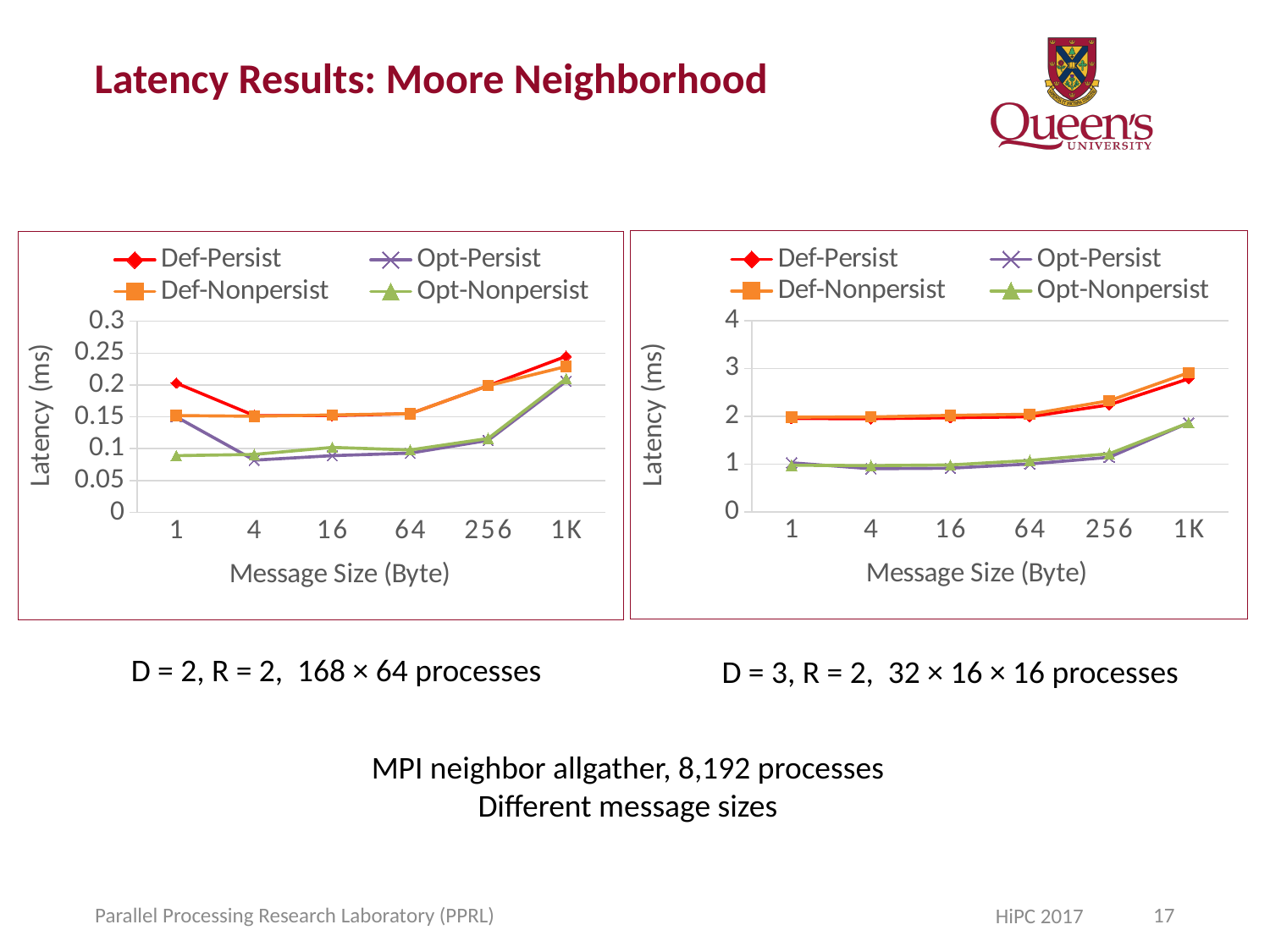
In the right chart (D = 3, R = 2), does the Def-Nonpersist latency rise or fall from message size 64 to 1K? rise In the right chart (D = 3, R = 2), is the Def-Persist value at message size 256 greater or less than 2? greater In the left chart (D = 2, R = 2), is the Opt-Persist value at message size 4 greater or less than 0.1? less In the left chart (D = 2, R = 2), is the Def-Persist value at message size 1K greater or less than 0.2? greater How many series does the legend of the right chart (D = 3, R = 2) list? 4 What is the x-axis title of the left chart (D = 2, R = 2)? Message Size (Byte) In the right chart (D = 3, R = 2), at message size 1, which is larger: Def-Nonpersist or Opt-Nonpersist? Def-Nonpersist How many message sizes are shown on the x axis of the left chart (D = 2, R = 2)? 6 In the left chart (D = 2, R = 2), which series has the highest latency at message size 1K? Def-Persist What kind of chart is the left chart (D = 2, R = 2)? Line chart